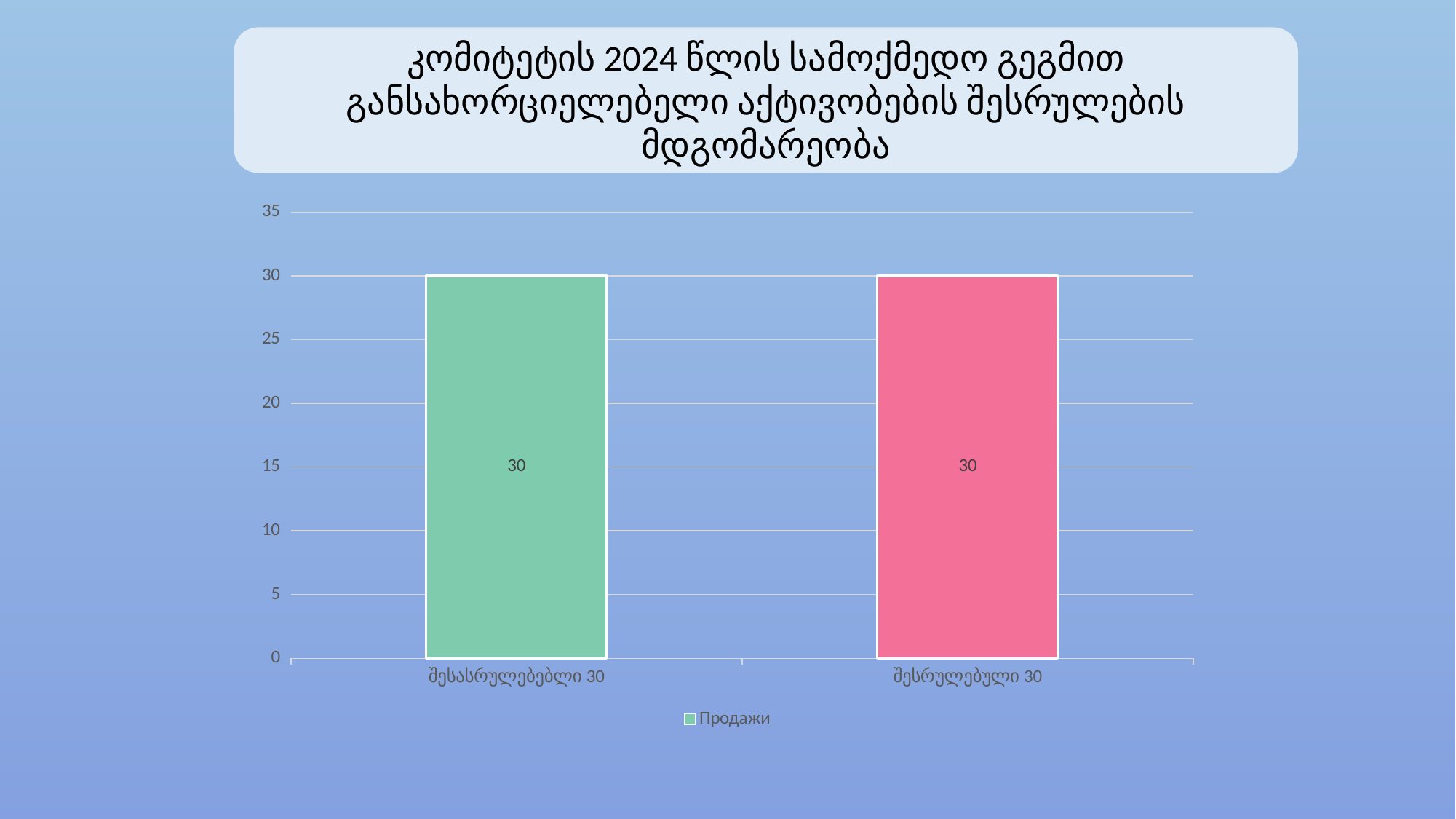
What colour is the bar for შესრულებული 30? pink What is the name of the series listed in the legend? Продажи Is the value for შესრულებული 30 greater or less than 35? less What kind of chart is shown on the slide? bar chart What is the value for შესრულებული 30? 30 What is the difference between the values for შესასრულებელი 30 and შესრულებული 30? 0 Is the value for შესასრულებელი 30 greater or less than 25? greater What is the value for შესასრულებელი 30? 30 How many series does the legend list? 1 What is the highest value shown on the y axis? 35 Do the values rise, fall or stay the same from the first category to the second? stay the same How many categories are shown on the x axis? 2